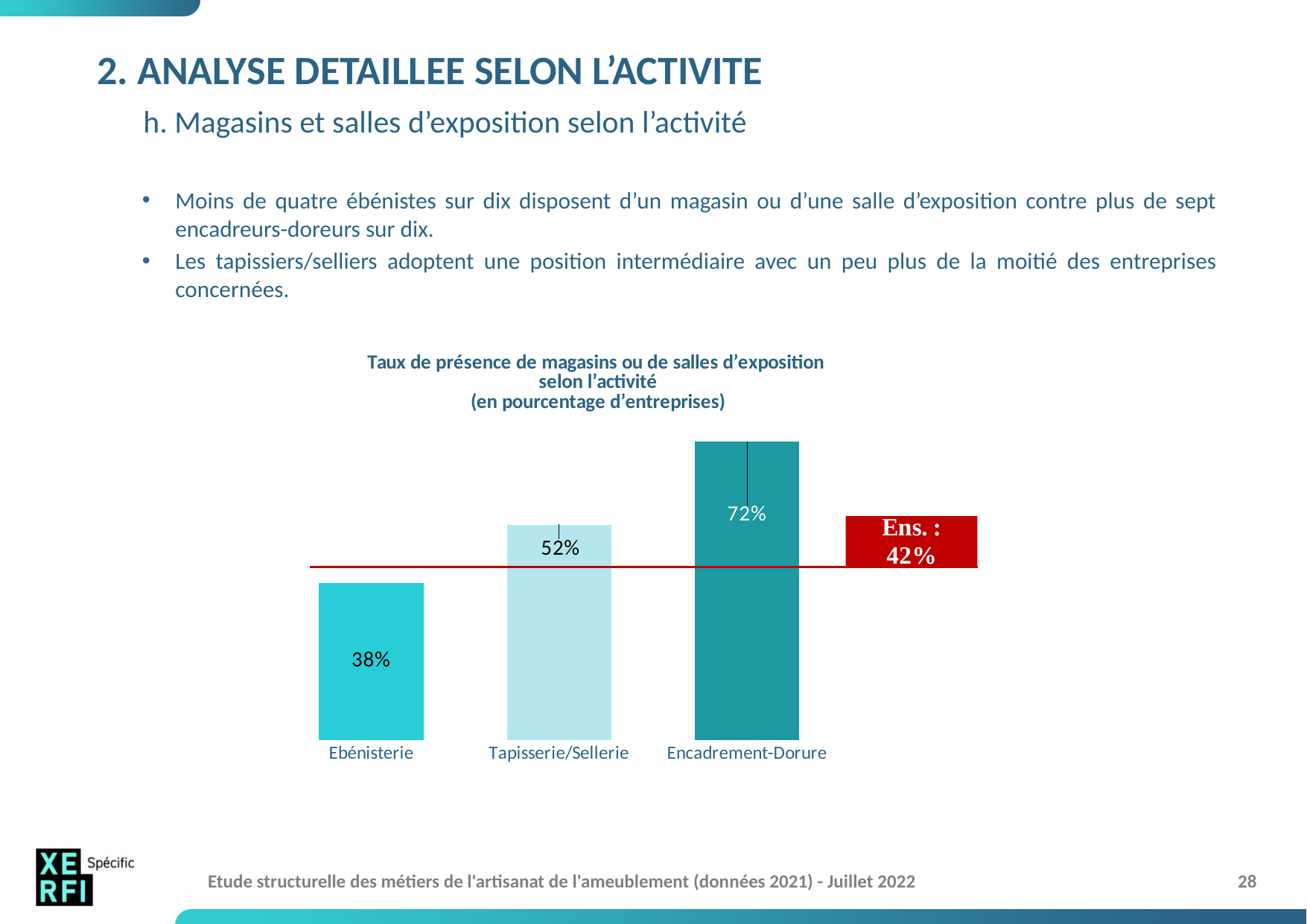
What is the value for Tapisserie/Sellerie? 52% What is the difference between Tapisserie/Sellerie and the overall value (Ens.)? 10 percentage points What is the value for Encadrement-Dorure? 72% How many activity categories are shown in the chart? 3 What is the title of the chart? Taux de présence de magasins ou de salles d'exposition selon l'activité (en pourcentage d'entreprises) Which activity has the highest rate of shops or showrooms? Encadrement-Dorure What is the overall value (Ens.) shown by the red line? 42% What is the value for Ebénisterie? 38% Which is larger, the value for Tapisserie/Sellerie or the value for Ebénisterie? Tapisserie/Sellerie What is the difference between Encadrement-Dorure and Ebénisterie? 34 percentage points Which activity has the lowest rate of shops or showrooms? Ebénisterie What kind of chart is shown on the slide? Bar chart